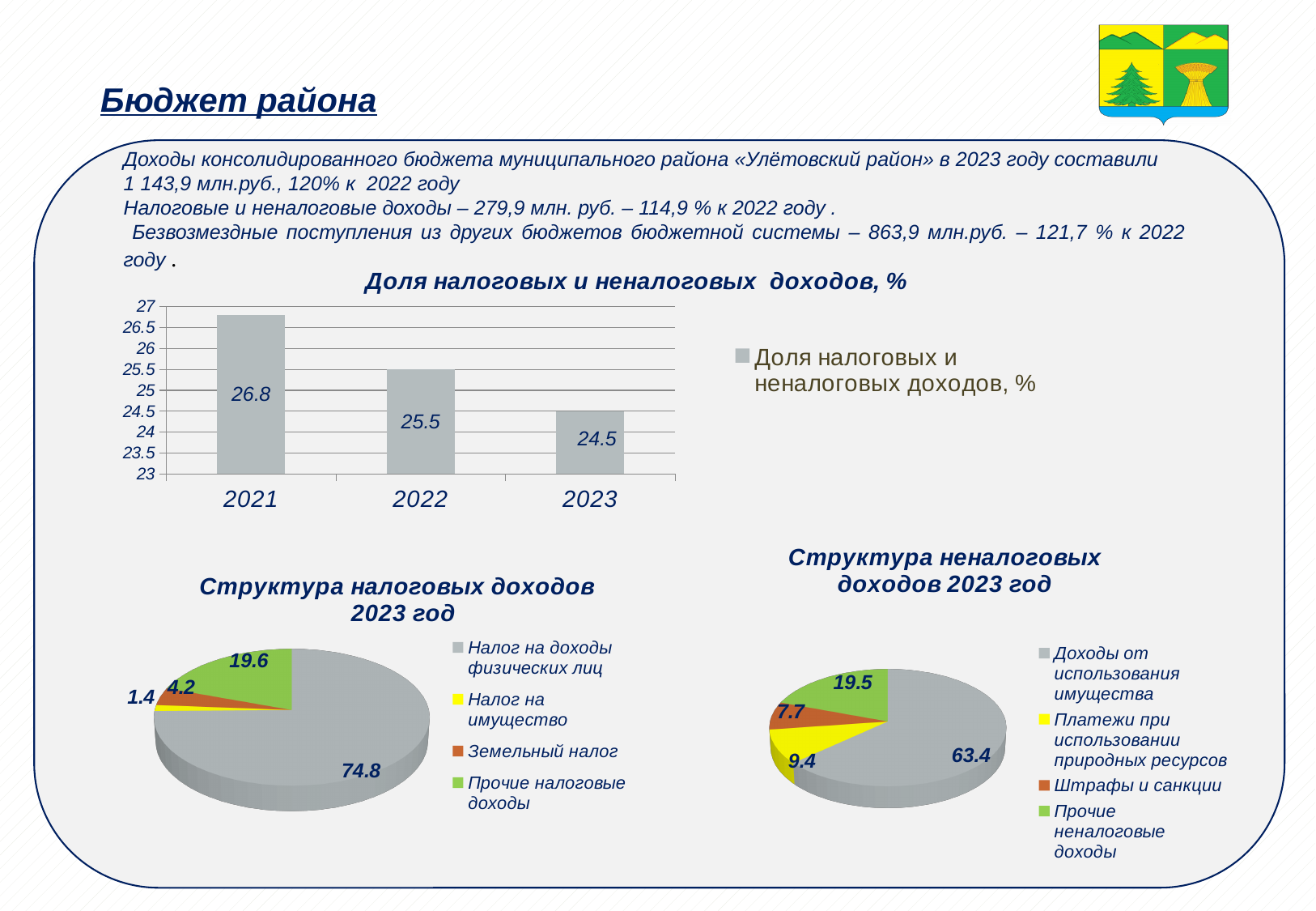
In the bar chart 'Доля налоговых и неналоговых доходов, %', do the values rise or fall from 2021 to 2023? fall How many categories does the legend of the pie chart 'Структура неналоговых доходов 2023 год' list? 4 In the pie chart 'Структура налоговых доходов 2023 год', which category has the smallest share? Налог на имущество In the pie chart 'Структура налоговых доходов 2023 год', what is the share of 'Налог на доходы физических лиц'? 74.8 In the pie chart 'Структура неналоговых доходов 2023 год', what is the share of 'Штрафы и санкции'? 7.7 In the pie chart 'Структура неналоговых доходов 2023 год', which is larger: 'Платежи при использовании природных ресурсов' or 'Прочие неналоговые доходы'? Прочие неналоговые доходы In the bar chart 'Доля налоговых и неналоговых доходов, %', which year has the highest value? 2021 In the bar chart 'Доля налоговых и неналоговых доходов, %', what is the value for 2023? 24.5 In the bar chart 'Доля налоговых и неналоговых доходов, %', what is the value for 2021? 26.8 In the bar chart 'Доля налоговых и неналоговых доходов, %', what is the difference between the 2021 and 2023 values? 2.3 How many years are shown in the bar chart 'Доля налоговых и неналоговых доходов, %'? 3 What type of chart is 'Доля налоговых и неналоговых доходов, %'? bar chart